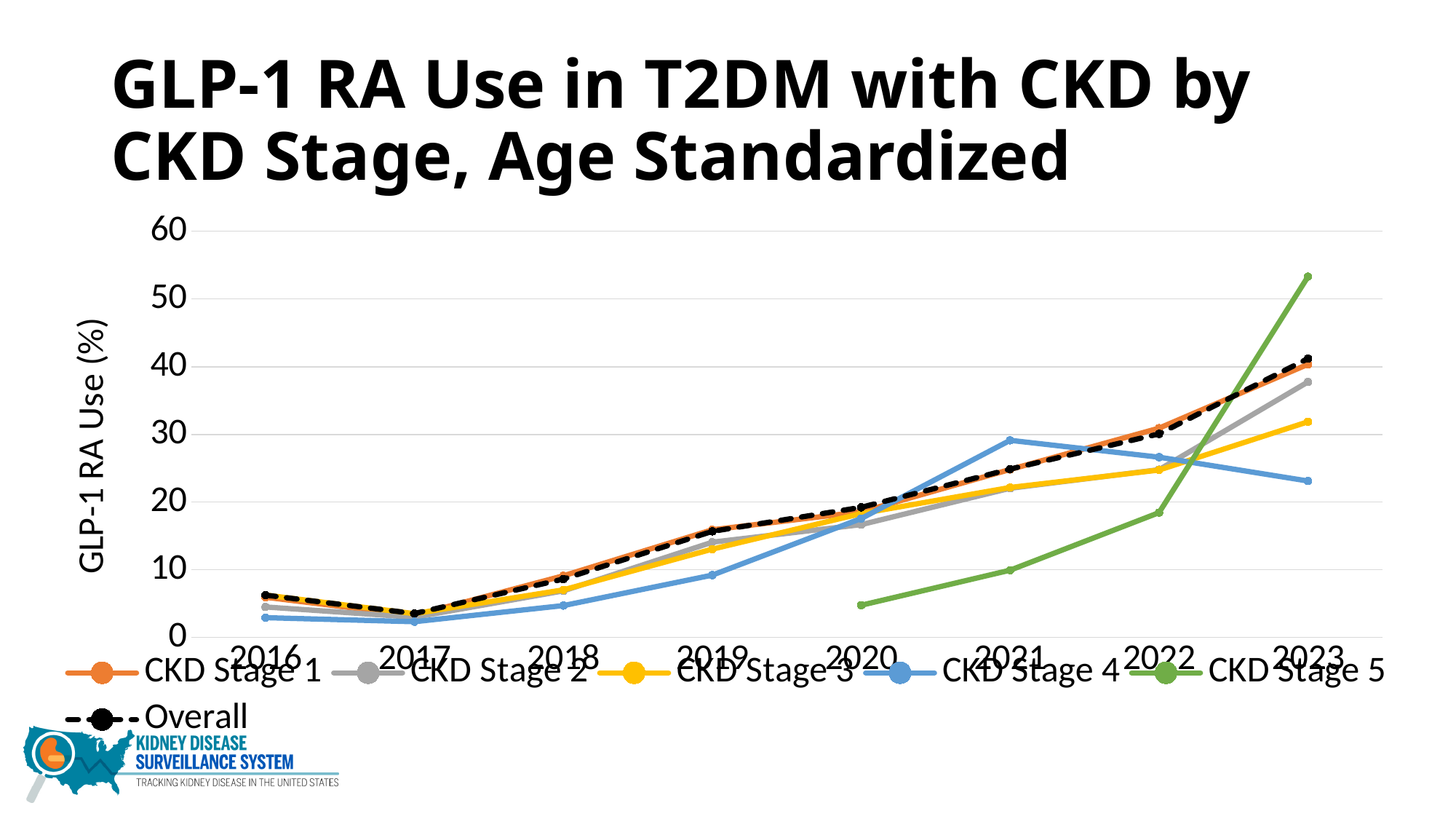
Is the value for CKD Stage 4 in 2023 greater or less than 30? less Is the Overall value in 2017 greater or less than 10? less Does the CKD Stage 4 series rise or fall from 2021 to 2023? Fall Does the Overall series rise or fall from 2017 to 2023? Rise Is the value for CKD Stage 5 in 2023 greater or less than 50? greater How many series does the legend list? 6 Which series has the highest value in 2023? CKD Stage 5 How many years are shown along the x axis? 8 What is the label on the y axis? GLP-1 RA Use (%) In 2021, which is larger: the value for CKD Stage 4 or the value for CKD Stage 3? CKD Stage 4 What kind of chart is shown on the slide? Line chart Which series has the lowest value in 2023? CKD Stage 4